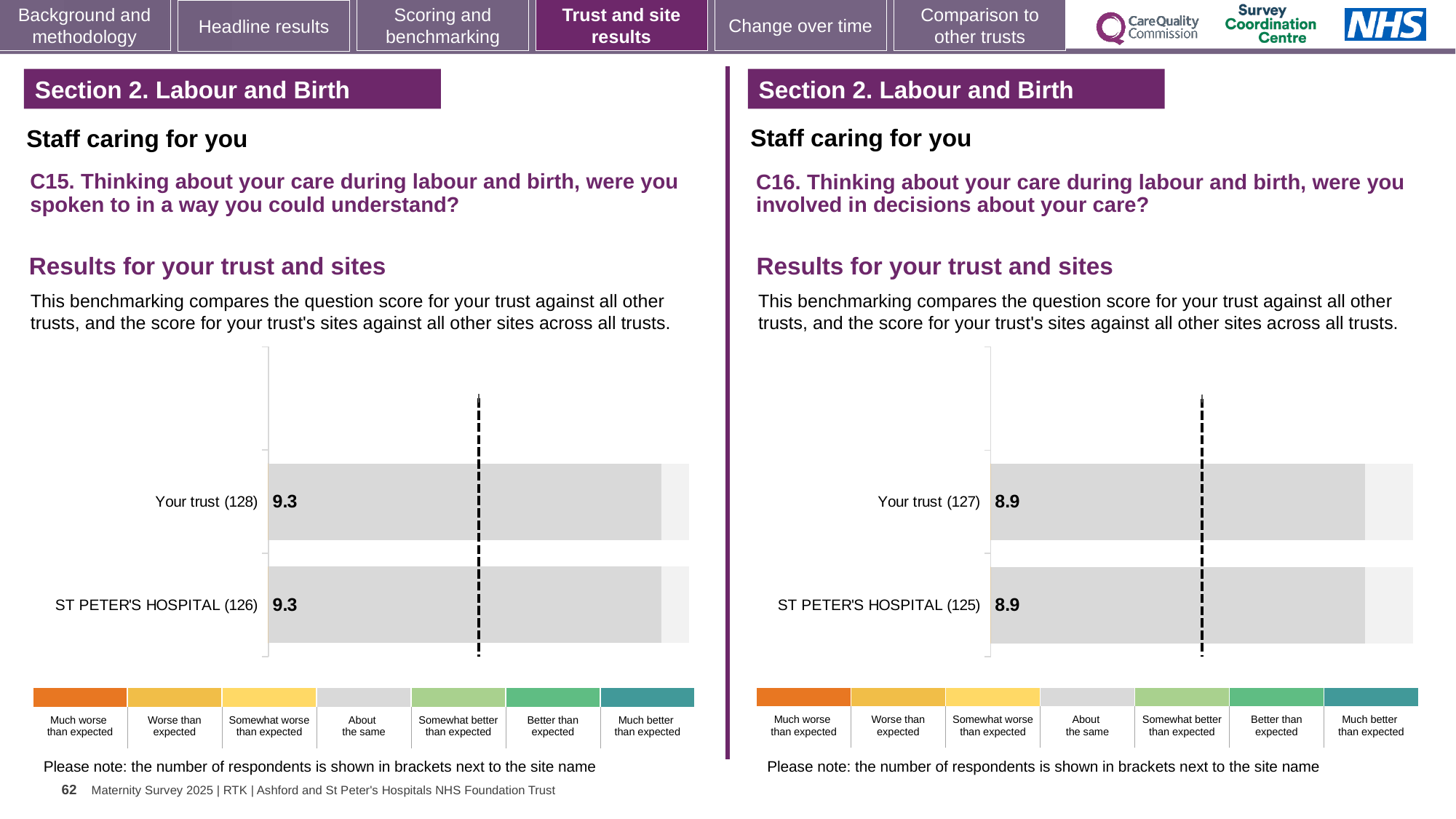
In the C15 chart on the left, what is the score for Your trust? 9.3 In the C15 chart on the left, what is the score for ST PETER'S HOSPITAL? 9.3 What is the difference between the Your trust score in the C15 chart on the left and the Your trust score in the C16 chart on the right? 0.4 In the C15 chart on the left, do Your trust and ST PETER'S HOSPITAL have the same score? Yes In the C15 chart on the left, how many respondents are shown in brackets for ST PETER'S HOSPITAL? 126 In the C16 chart on the right, what is the score for Your trust? 8.9 In the C16 chart on the right, what is the score for ST PETER'S HOSPITAL? 8.9 In the C16 chart on the right, how many respondents are shown in brackets for Your trust? 127 How many bars are plotted in the C16 chart on the right? 2 What kind of chart is used for the C16 results on the right? bar chart How many bars are plotted in the C15 chart on the left? 2 Is the score for Your trust in the C15 chart on the left larger or smaller than the score for Your trust in the C16 chart on the right? larger